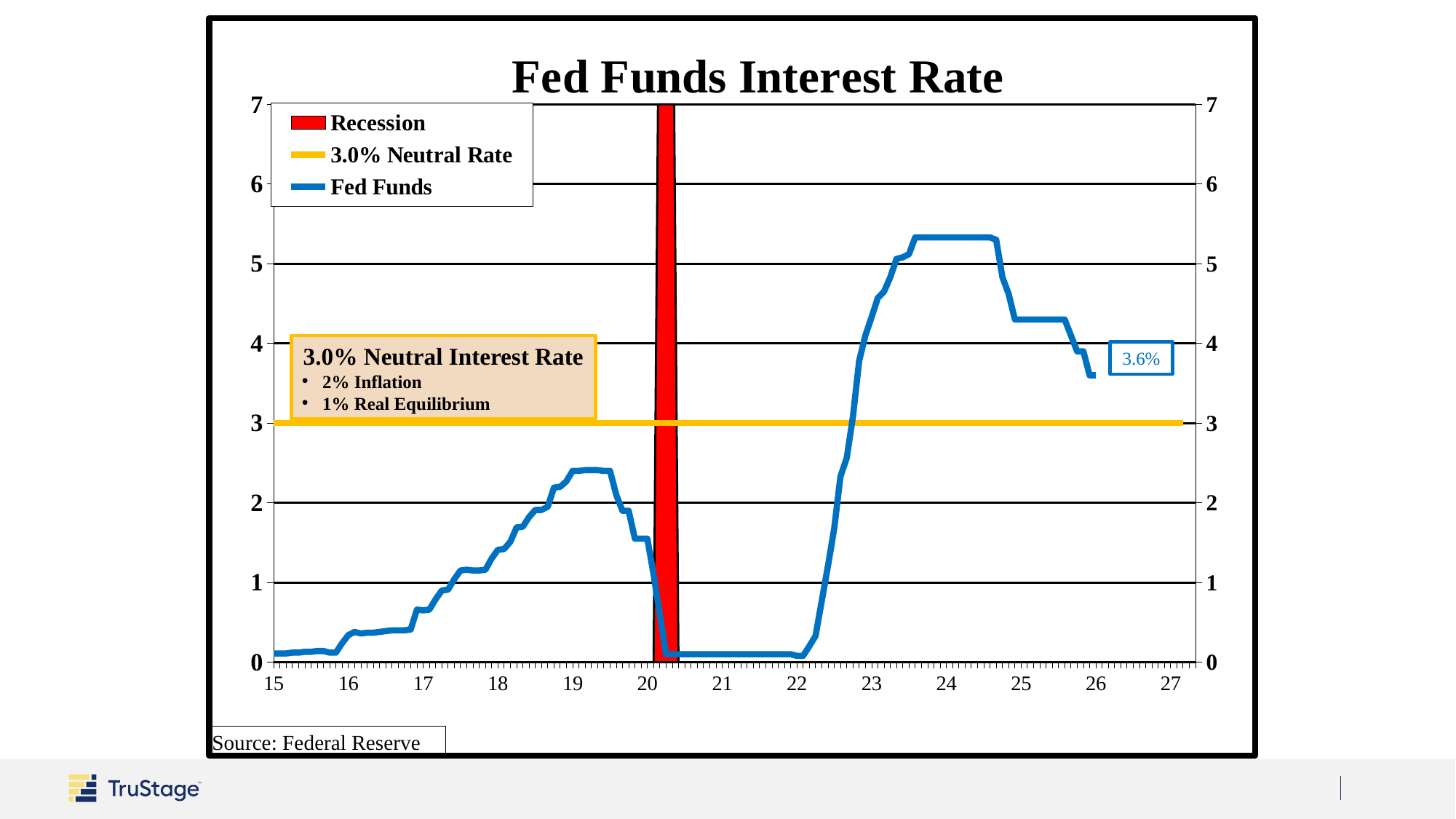
Does the Fed Funds line rise or fall between 2024 and 2026? fall What kind of chart is shown on the slide? line chart How many entries does the chart's legend list? 3 What is the title of the chart? Fed Funds Interest Rate What colour is used to mark the Recession period in the chart? red Is the Fed Funds rate at its 2019 peak greater or less than 3? less What level is the yellow Neutral Rate line drawn at? 3.0% Does the Fed Funds line rise or fall between 2022 and 2023? rise Which is higher, the Fed Funds rate in 2024 or in 2019? 2024 Is the Fed Funds rate in 2024 greater or less than 5? greater Is the Fed Funds rate in 2021 greater or less than 1? less What value is labeled at the end of the Fed Funds line? 3.6%